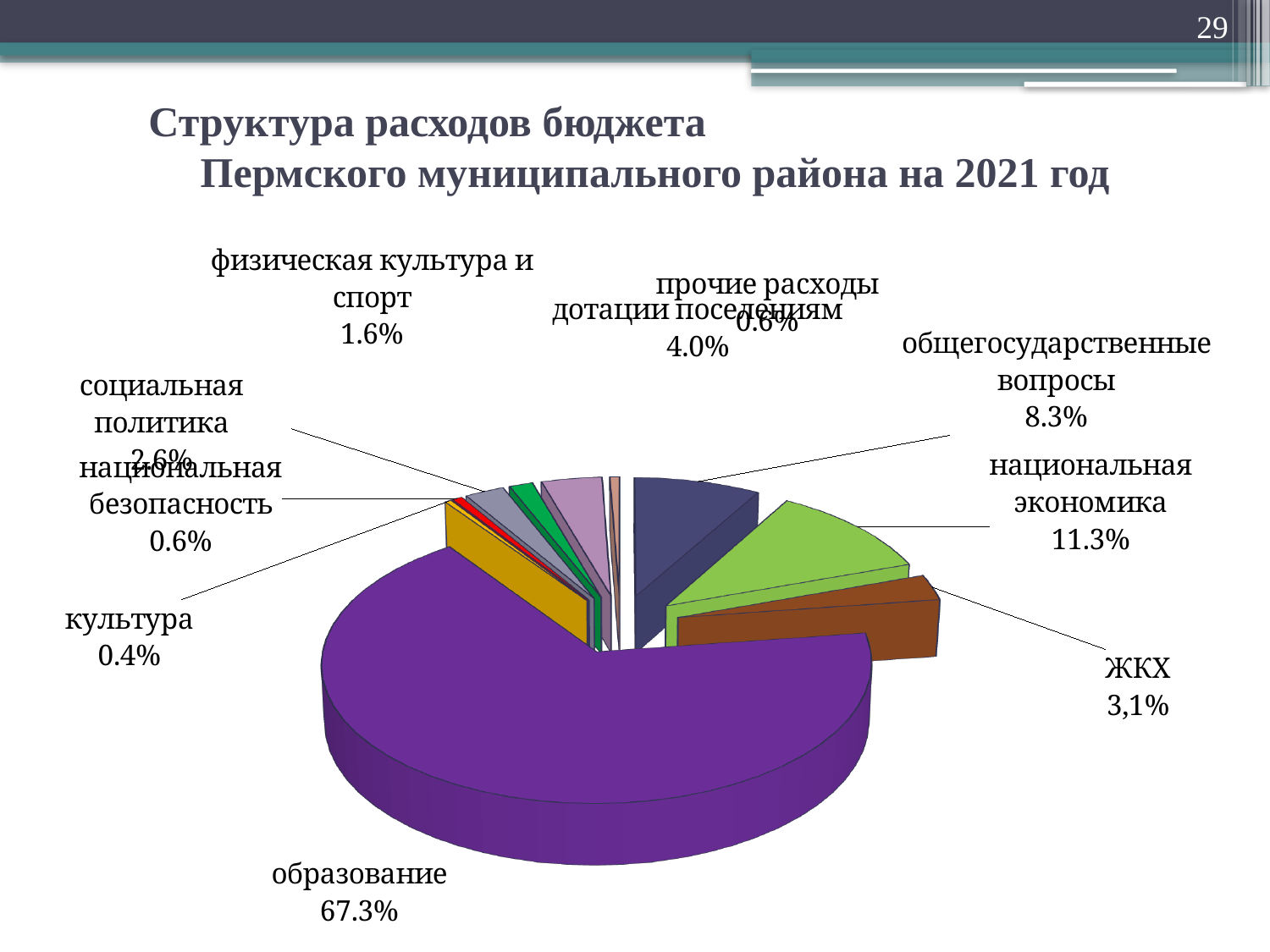
What is the value shown for ЖКХ? 3,1% By how many percentage points does национальная экономика exceed общегосударственные вопросы? 3.0 percentage points What is the value shown for общегосударственные вопросы? 8.3% What share of the budget expenditure goes to образование? 67.3% How many categories are shown in the pie chart? 10 What is the value shown for национальная экономика? 11.3% What is the value shown for физическая культура и спорт? 1.6% Which is larger, the share for дотации поселениям or the share for ЖКХ? дотации поселениям Which category has the smallest share of the pie? культура What is the value shown for дотации поселениям? 4.0% Which category has the largest share of the pie? образование What kind of chart is shown on the slide? pie chart